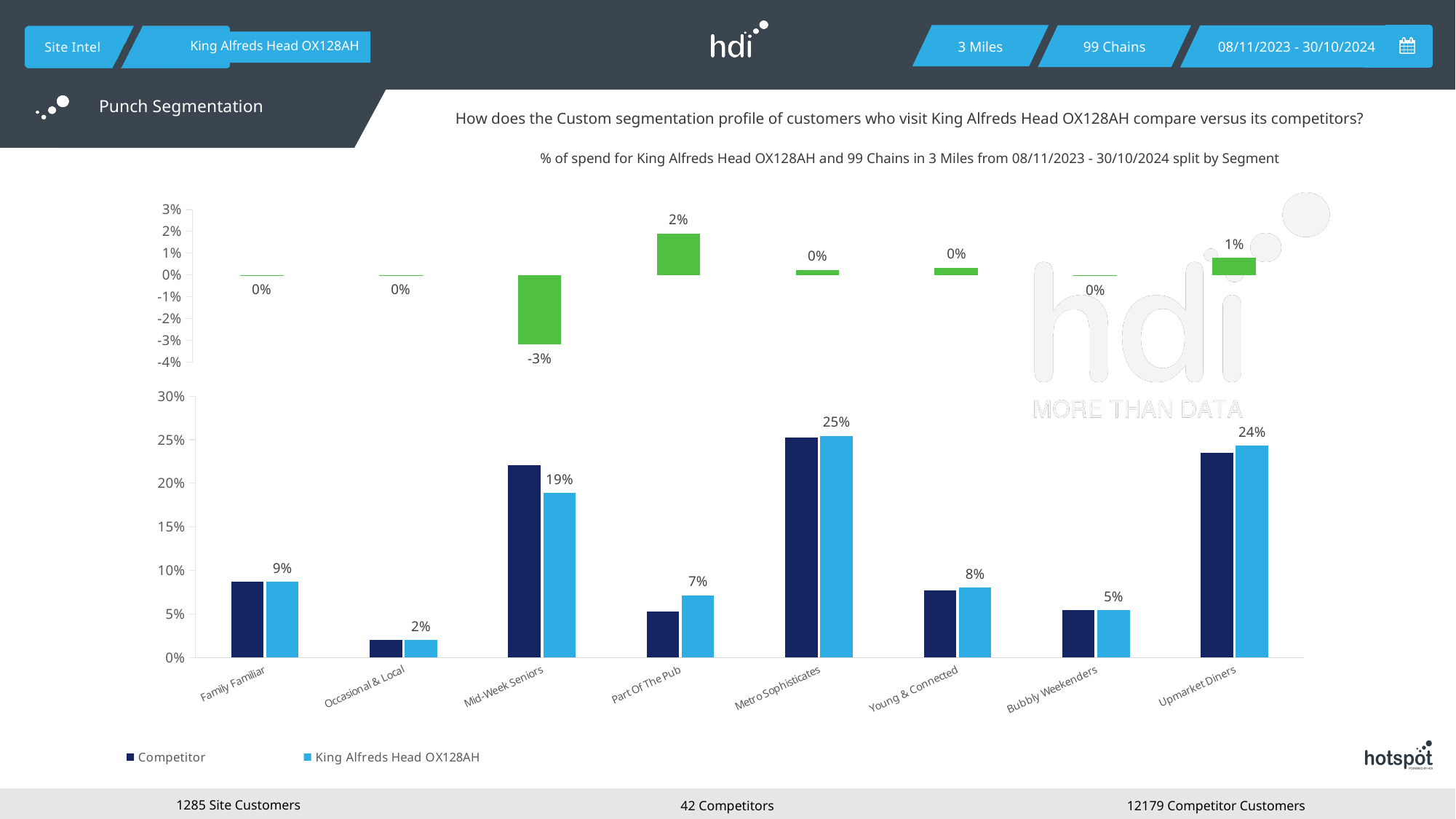
In the bottom chart, what is the value for King Alfreds Head OX128AH in the Metro Sophisticates segment? 25% In the top chart, what is the value shown for Mid-Week Seniors? -3% In the bottom chart, is the King Alfreds Head OX128AH value for Family Familiar larger or smaller than its value for Young & Connected? larger In the bottom chart, what is the difference between the King Alfreds Head OX128AH values for Upmarket Diners and Bubbly Weekenders? 19% In the bottom chart, what is the value for King Alfreds Head OX128AH in the Mid-Week Seniors segment? 19% In the top chart, which segment has the highest value? Part Of The Pub In the bottom chart, is the Competitor value for Mid-Week Seniors greater or less than 20%? greater How many segments are shown on the x axis of the bottom chart? 8 How many series does the legend of the bottom chart list? 2 In the bottom chart, which segment has the highest value for King Alfreds Head OX128AH? Metro Sophisticates In the bottom chart, is the Competitor value for Family Familiar greater or less than 10%? less In the bottom chart, which segment has the lowest value for King Alfreds Head OX128AH? Occasional & Local